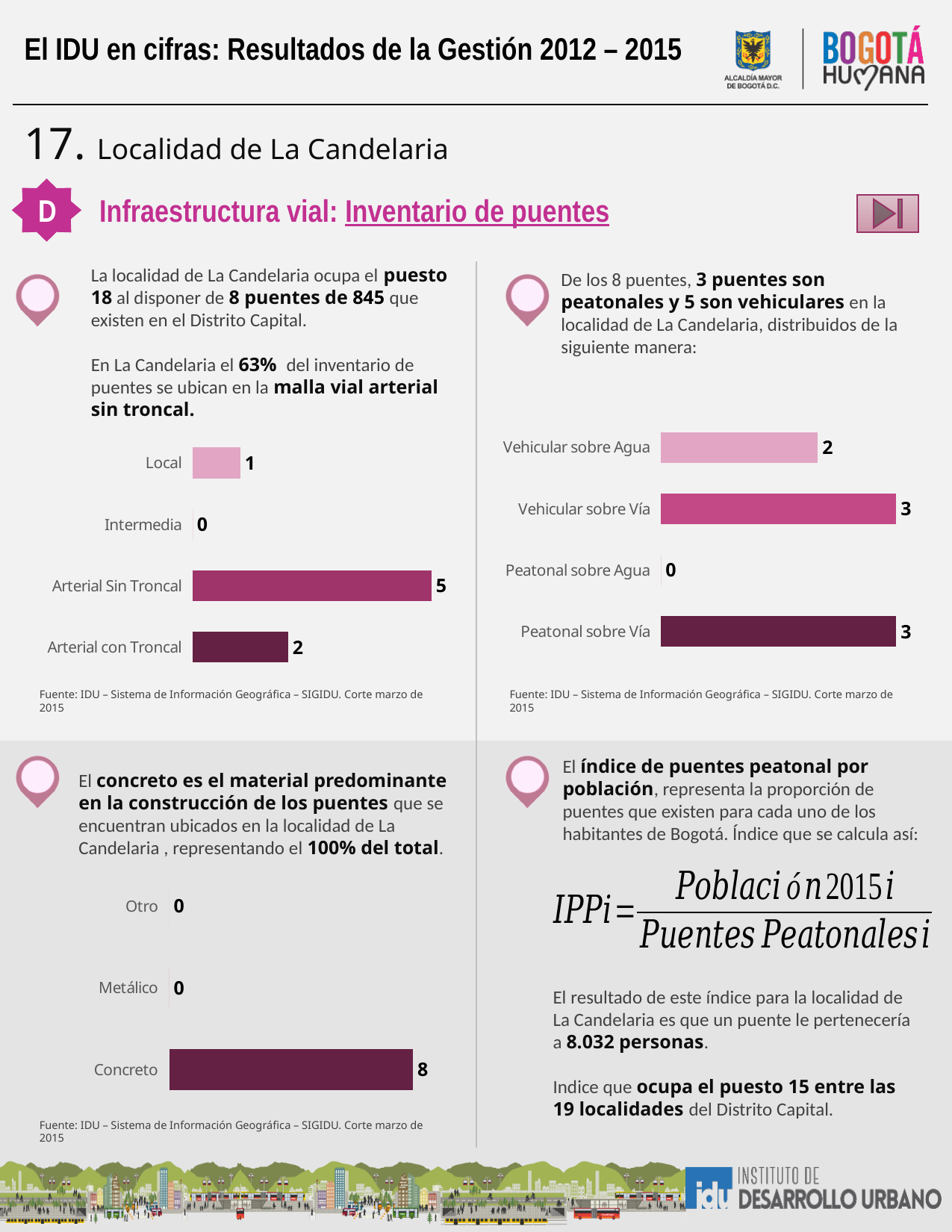
In the top-right chart, which is larger: Vehicular sobre Vía or Vehicular sobre Agua? Vehicular sobre Vía In the bottom-left chart, what is the value for Concreto? 8 In the top-right chart, what is the value for Vehicular sobre Agua? 2 In the top-right chart, what is the total of all four categories? 8 In the top-left chart, what is the difference between Arterial Sin Troncal and Arterial con Troncal? 3 In the top-left chart, how many categories are shown? 4 In the top-left chart, what is the value for Intermedia? 0 In the bottom-left chart, how many categories are shown? 3 In the top-right chart, which category has the lowest value? Peatonal sobre Agua In the top-left chart, what is the value for Arterial Sin Troncal? 5 In the top-left chart, which category has the highest value? Arterial Sin Troncal What kind of chart is the bottom-left chart? Bar chart